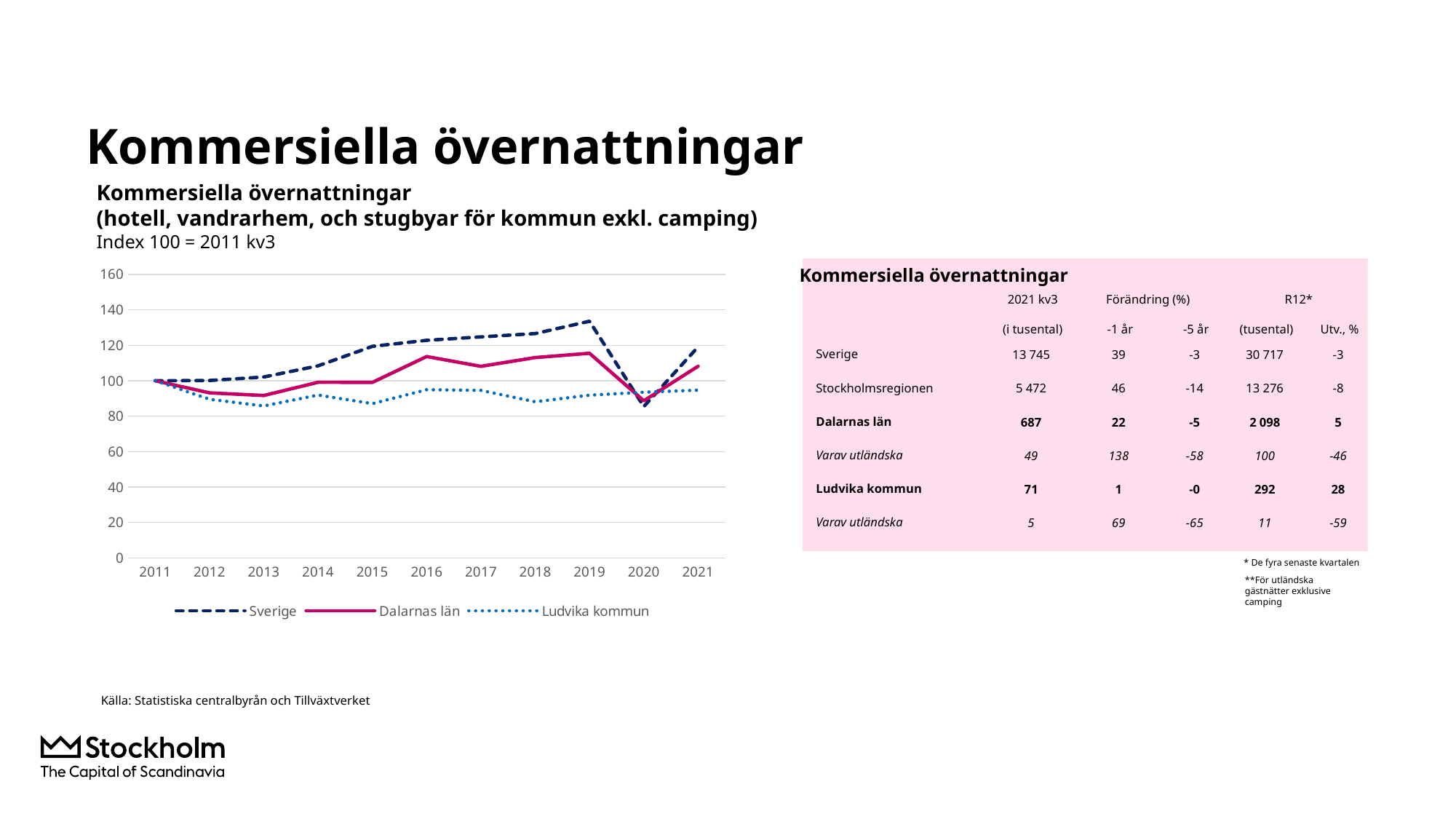
Does the Sverige series rise or fall between 2011 and 2019? rise How many years are shown on the x axis of the chart? 11 What kind of chart is shown on the slide? line chart Is the value for Dalarnas län in 2016 greater or less than 100? greater Is the value for Sverige in 2020 greater or less than 100? less Is the value for Ludvika kommun in 2013 greater or less than 100? less Which is larger in 2021, the value for Sverige or the value for Dalarnas län? Sverige How many series does the chart legend list? 3 In which year does the Sverige series reach its highest value? 2019 Which series has the highest value in 2019? Sverige What is the index value for all three series in 2011? 100